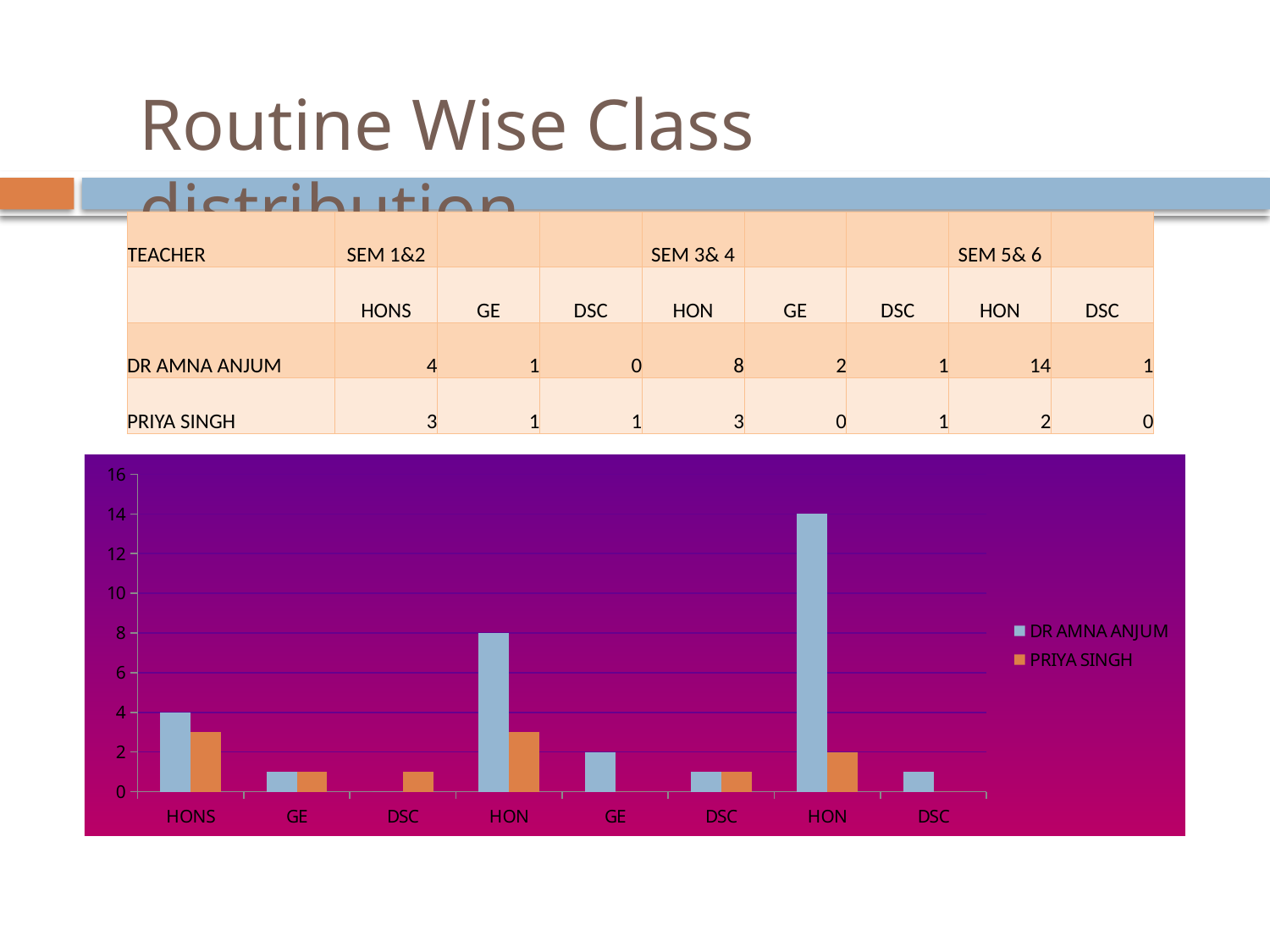
How many series does the chart legend list? 2 What is the value for DR AMNA ANJUM in the HONS category? 4 What type of chart is shown on the slide? bar chart In which category does DR AMNA ANJUM have the highest value? HON (SEM 5& 6) In the HONS category, which series has the larger value, DR AMNA ANJUM or PRIYA SINGH? DR AMNA ANJUM Which colour represents PRIYA SINGH in the chart legend? orange Is the value for DR AMNA ANJUM in the second HON category (SEM 5& 6) greater or less than 10? greater What is the value for DR AMNA ANJUM in the second HON category (SEM 5& 6)? 14 What is the difference between DR AMNA ANJUM and PRIYA SINGH in the second HON category (SEM 5& 6)? 12 How many categories are shown along the x axis of the chart? 8 What is the difference between DR AMNA ANJUM and PRIYA SINGH in the HONS category? 1 What is the value for PRIYA SINGH in the HONS category? 3